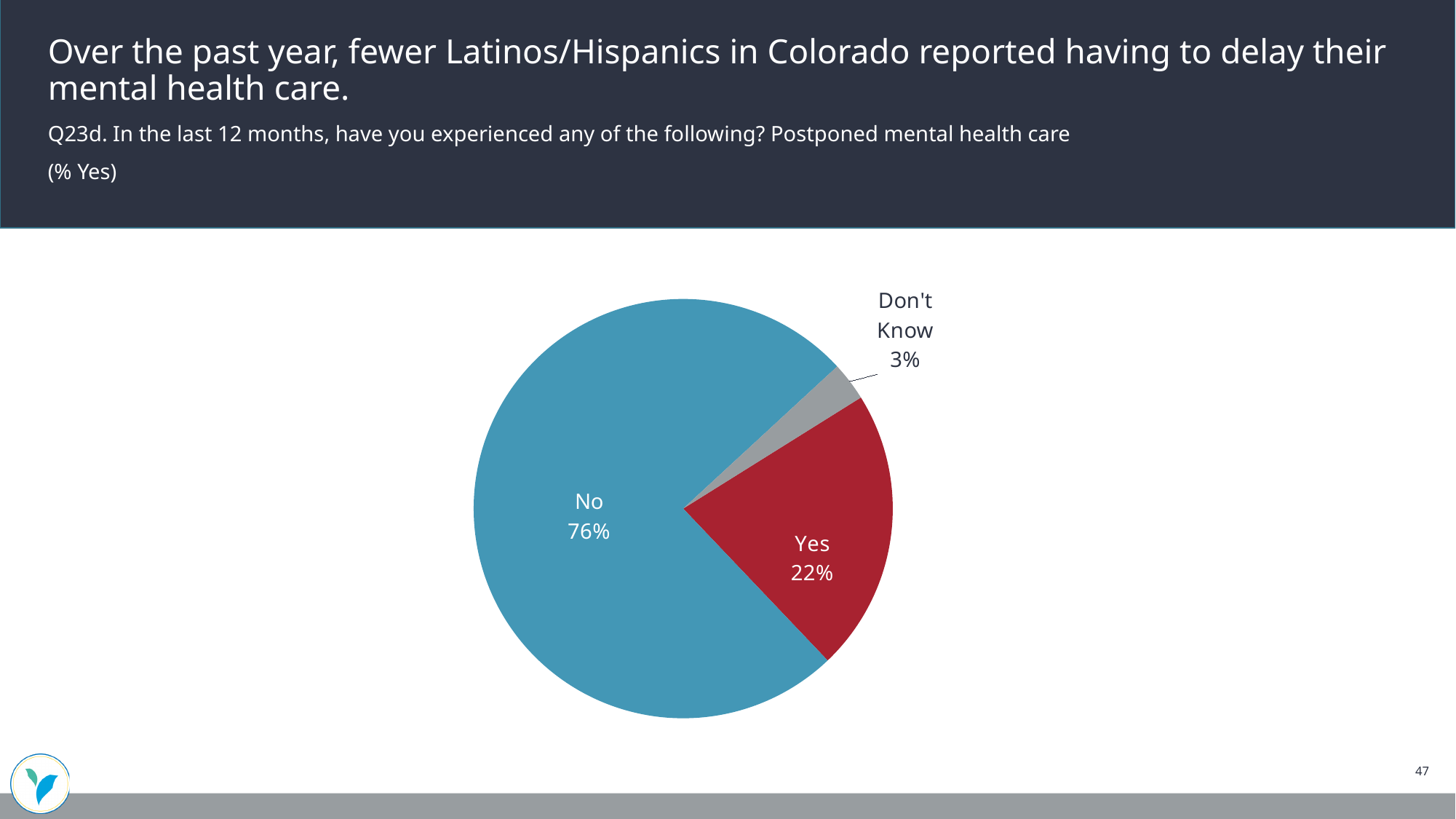
How many slices does the pie chart have? 3 What colour is the "No" slice? blue Which response has the smallest share of the pie? Don't Know What percentage of respondents answered "Yes"? 22% Which is larger, the "Yes" slice or the "Don't Know" slice? Yes What colour is the "Yes" slice? red What is the difference in percentage points between the "Yes" and "Don't Know" slices? 19 What kind of chart is shown on the slide? pie chart What percentage of respondents answered "No"? 76% Which response has the largest share of the pie? No What is the difference in percentage points between the "No" and "Yes" slices? 54 What percentage of respondents answered "Don't Know"? 3%